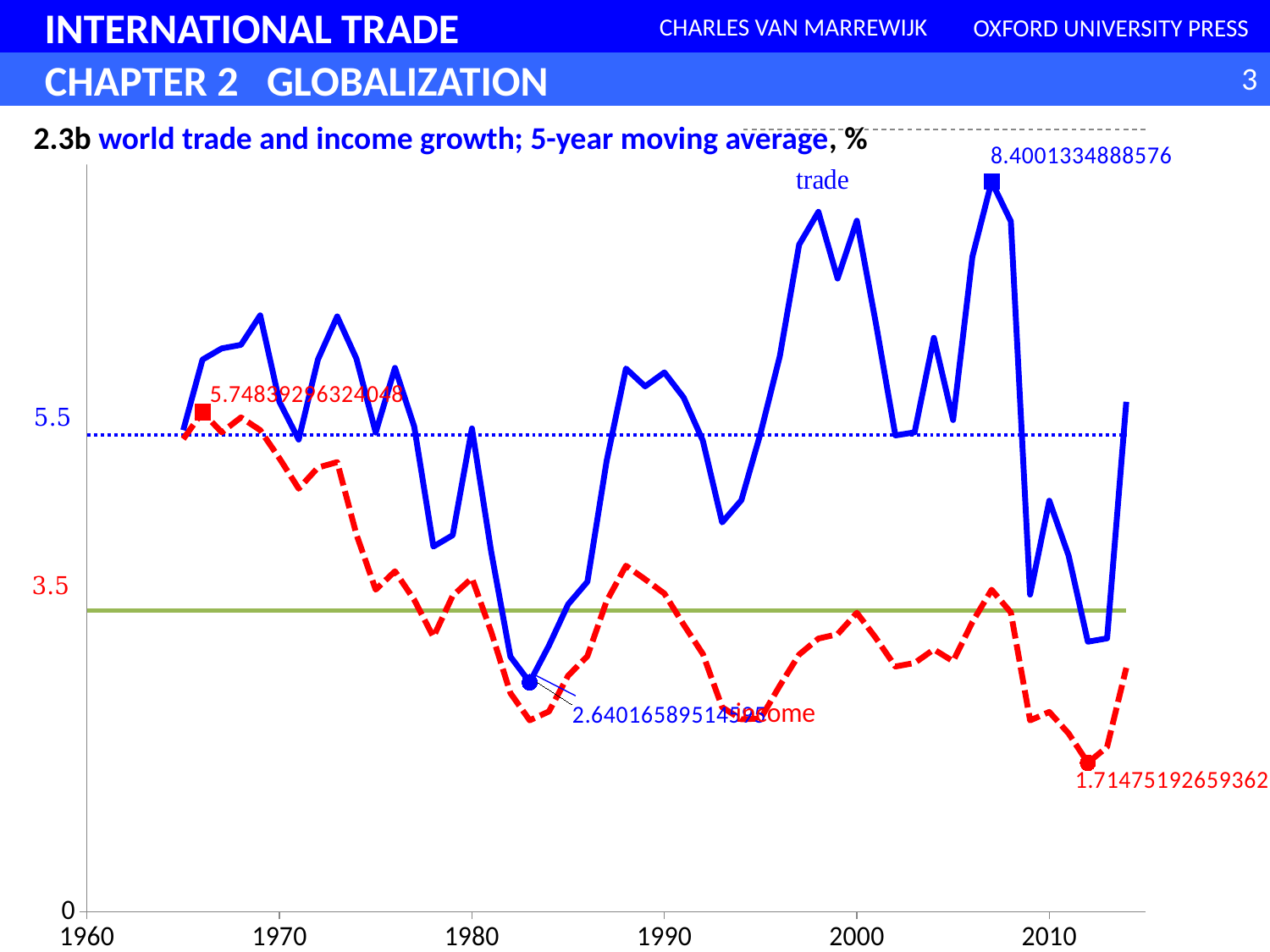
What type of chart is shown on the slide? line chart What is the lowest labelled value of the income series? 1.71475192659362 Is the trade value around 1998 greater or less than 5.5? greater Which series is drawn as a red dashed line? income What is the title of the chart? 2.3b world trade and income growth; 5-year moving average, % Which series reaches the highest value on the chart? trade What is the highest labelled value of the trade series? 8.4001334888576 Around 2007, which series has the larger value, trade or income? trade Does the income series generally rise or fall between 1966 and 1983? fall Is the income value around 2012 greater or less than 3.5? less Is the trade value around 1983 greater or less than 3.5? less How many data series are plotted on the chart? 4